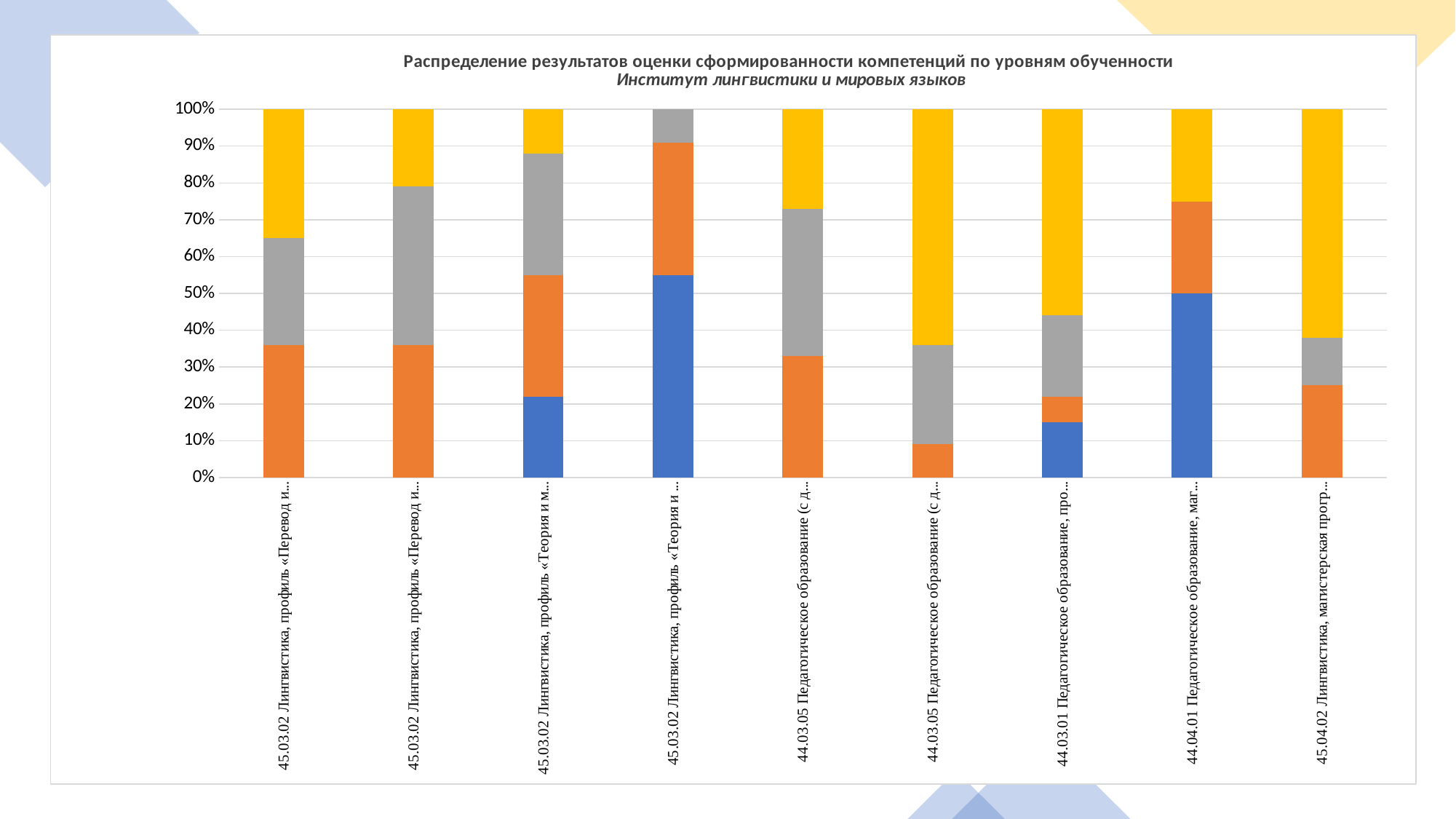
What kind of chart is shown on the slide? Stacked bar chart In the second bar from the left, is the top of the grey segment greater or less than 70%? greater In the first bar from the left, is the top of the orange segment greater or less than 30%? greater In the seventh bar from the left, is the top of the blue segment greater or less than 20%? less What is the name of the institute given in the chart's subtitle? Институт лингвистики и мировых языков Which bar is the only one with no yellow segment? The fourth bar from the left Which bar has the largest blue segment, the fourth bar or the eighth bar from the left? The fourth bar What is the maximum value shown on the vertical axis? 100% How many bars (categories) are plotted in the chart? 9 How many bars contain a blue segment? 4